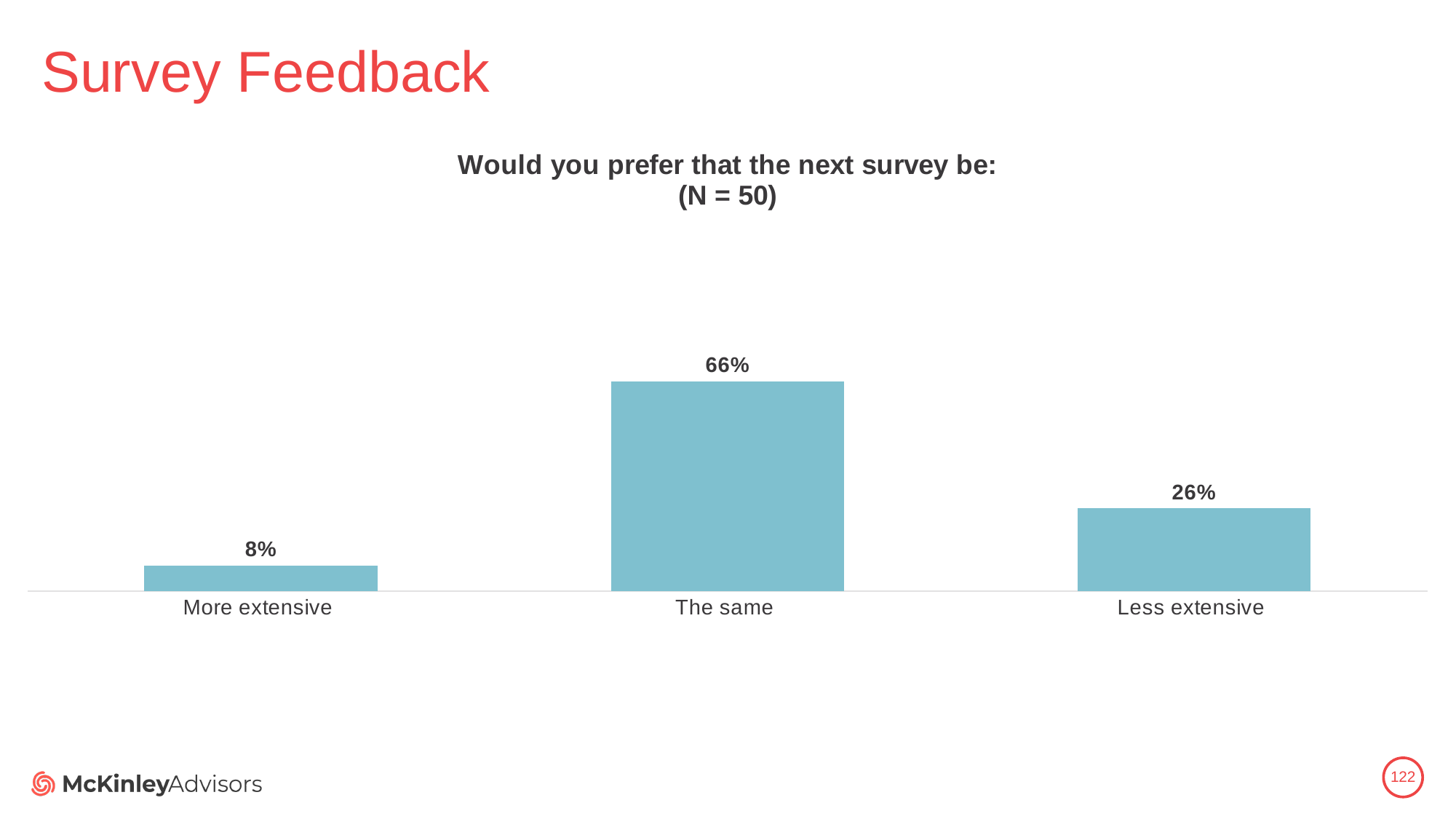
What is the title of the chart? Would you prefer that the next survey be: (N = 50) Which has a larger value, 'Less extensive' or 'More extensive'? Less extensive What is the difference in percentage points between 'The same' and 'Less extensive'? 40 What percentage of respondents preferred that the next survey be 'The same'? 66% What is the difference in percentage points between 'Less extensive' and 'More extensive'? 18 How many response categories are shown in the chart? 3 What is the sample size (N) stated in the chart title? 50 What percentage of respondents preferred that the next survey be 'Less extensive'? 26% Which response option has the lowest percentage? More extensive Which response option has the highest percentage? The same What type of chart is shown on the slide? Bar chart What percentage of respondents preferred that the next survey be 'More extensive'? 8%